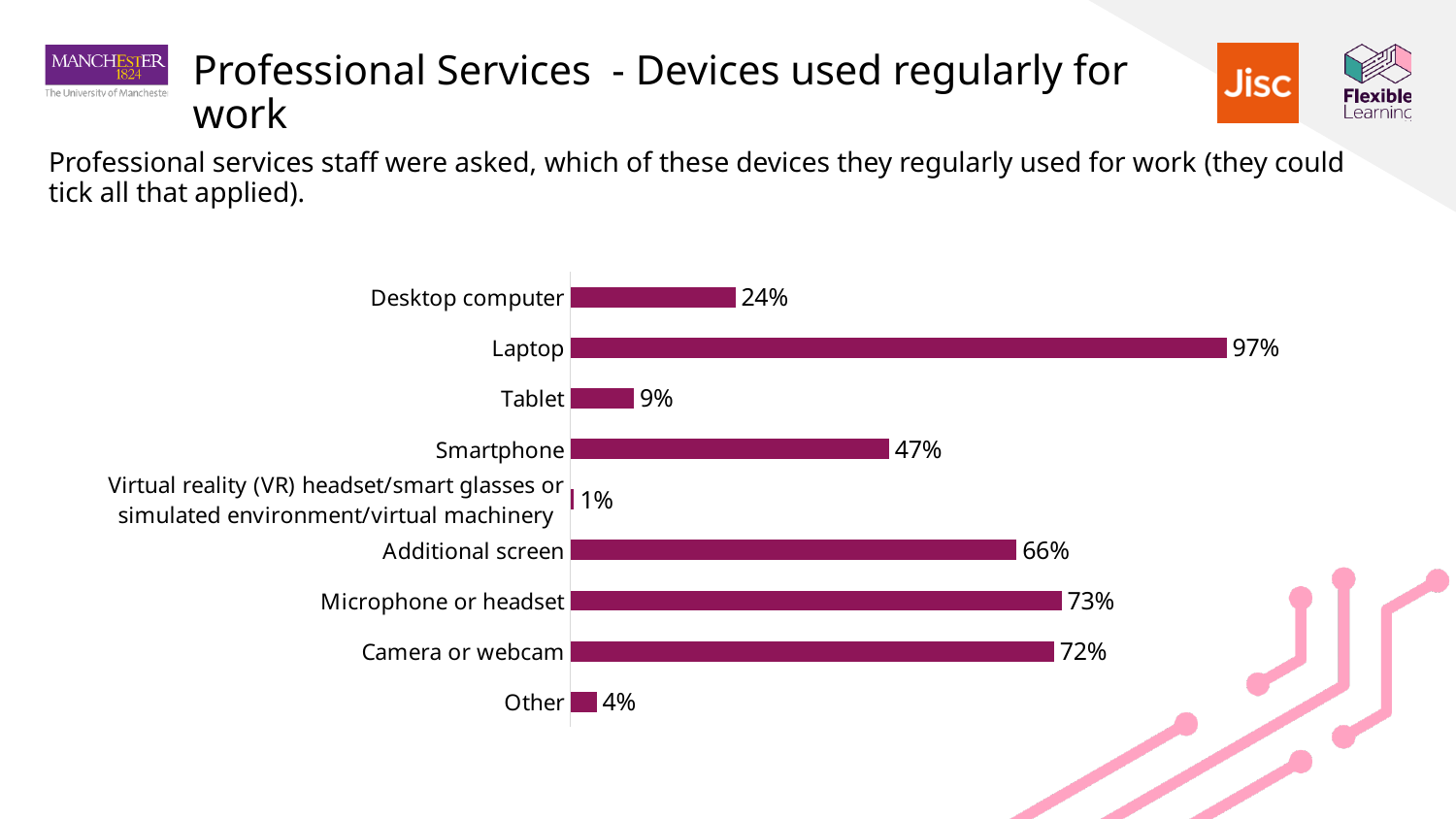
How many device categories are shown in the chart? 9 What kind of chart is shown on the slide? Bar chart What is the value shown for Smartphone? 47% What is the difference in percentage points between Laptop and Desktop computer? 73 Which is larger, the value for Additional screen or the value for Smartphone? Additional screen What percentage is shown for Additional screen? 66% What is the difference between Microphone or headset and Camera or webcam? 1 percentage point Which device has the highest percentage in the chart? Laptop What colour are the bars in the chart? Purple Which category has the lowest percentage in the chart? Virtual reality (VR) headset/smart glasses or simulated environment/virtual machinery Which is larger, the value for Tablet or the value for Other? Tablet What percentage of professional services staff regularly use a laptop for work? 97%